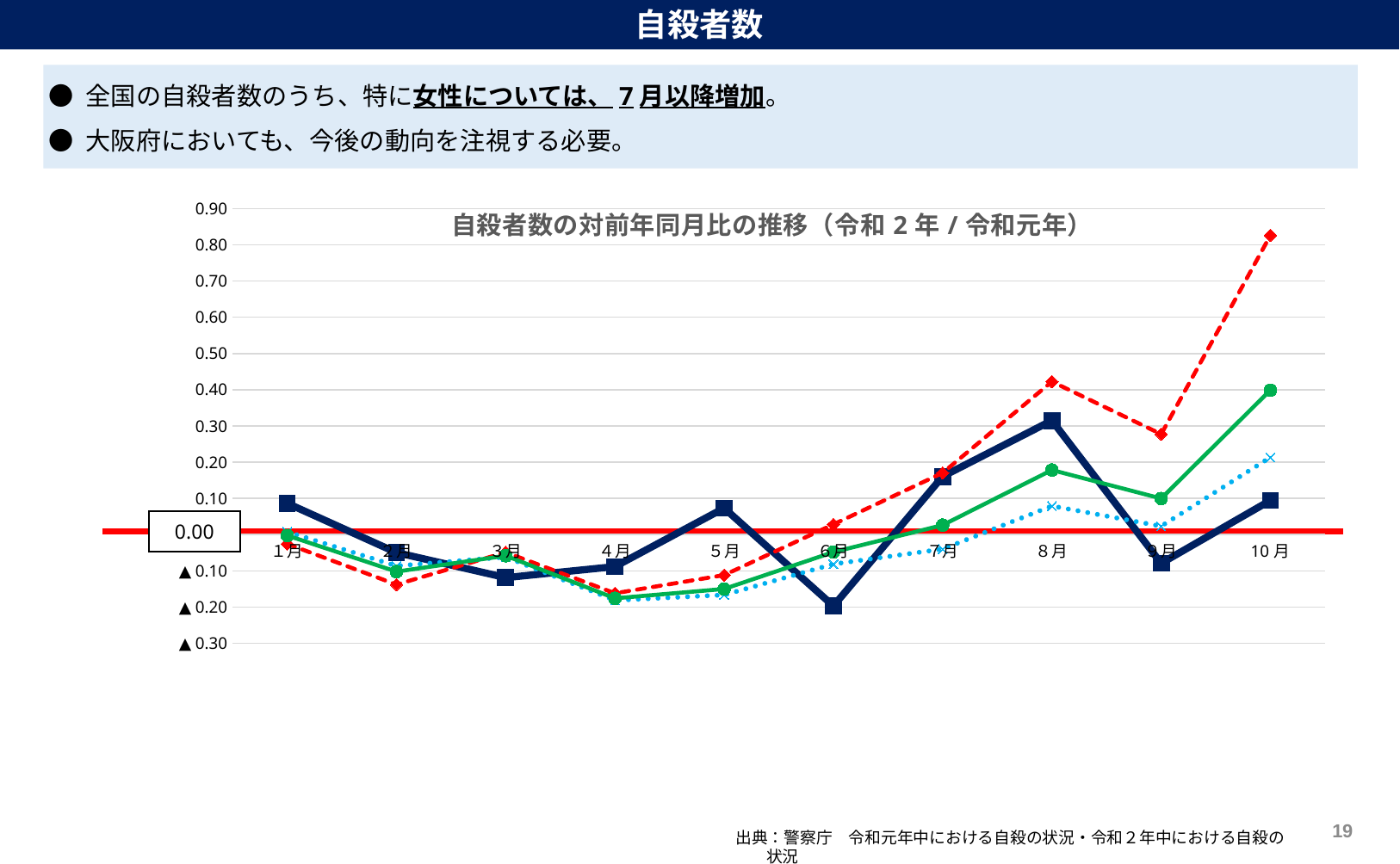
Does the red dashed line rise or fall from 4月 to 8月? rise In 10月, which line has the larger value: the red dashed line or the green line? the red dashed line What kind of chart is shown on the slide? line chart In which month does the green line with circle markers reach its highest value? 10月 What is the title of the chart? 自殺者数の対前年同月比の推移（令和２年／令和元年） In which month does the dark navy line with square markers reach its lowest value? 6月 In 8月, which line has the larger value: the dark navy line or the green line? the dark navy line How many months are plotted along the x axis of the chart? 10 Is the value of the red dashed line in 10月 greater or less than 0.70? greater In which month does the red dashed line reach its highest value? 10月 Is the value of the green line in 10月 greater or less than 0.30? greater Is the value of the dark navy line in 6月 greater or less than ▲0.10? less